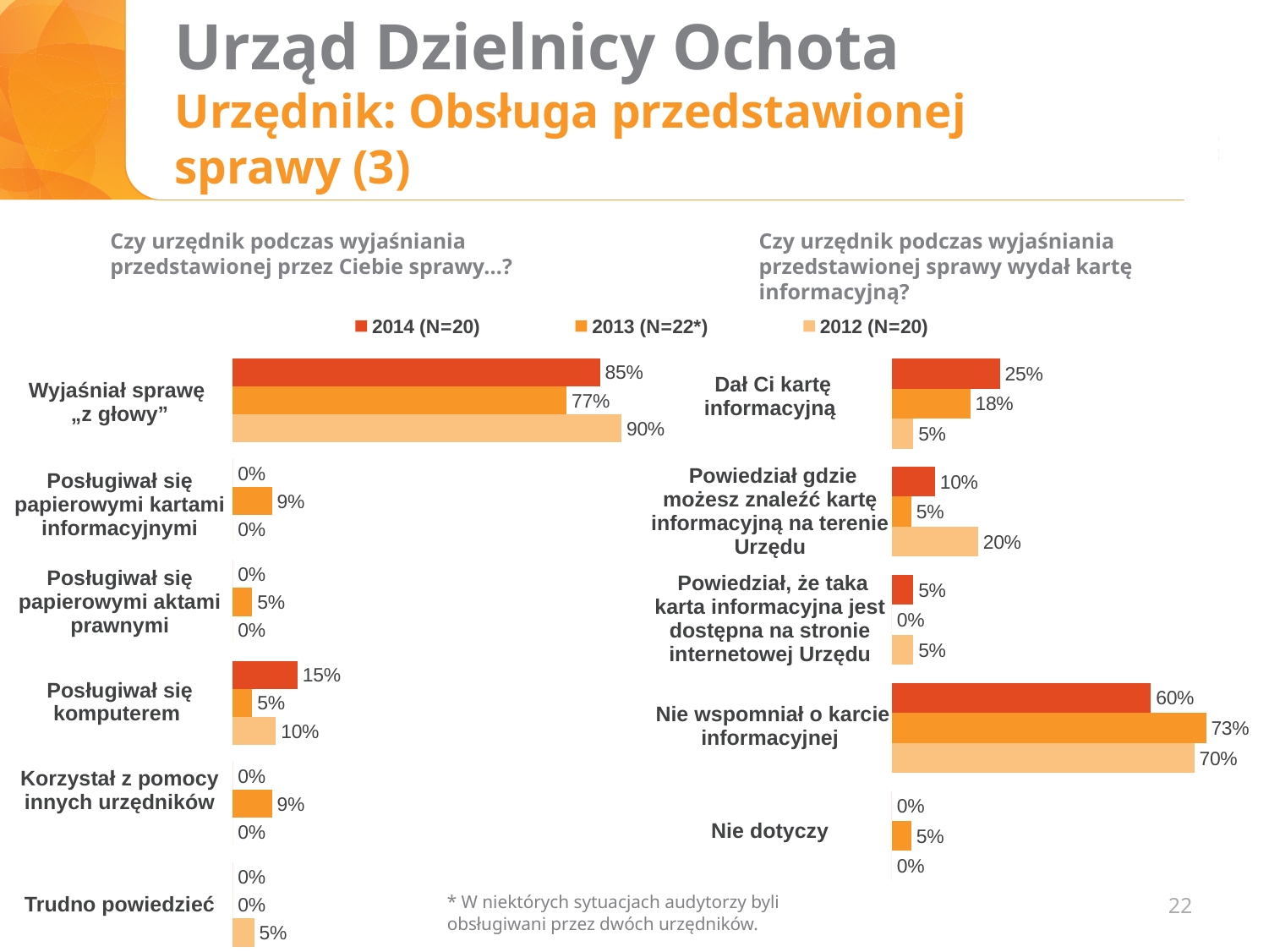
In the right chart, what is the 2012 value for "Powiedział gdzie możesz znaleźć kartę informacyjną na terenie Urzędu"? 20% In the left chart, what is the 2014 value for "Wyjaśniał sprawę „z głowy”"? 85% How many categories does the right chart show? 5 In the left chart, what is the 2013 value for "Posługiwał się papierowymi kartami informacyjnymi"? 9% In the right chart, what is the difference between the 2014 and 2012 values for "Dał Ci kartę informacyjną"? 20 percentage points How many series does the legend list? 3 In the left chart, which year has the lowest value for "Wyjaśniał sprawę „z głowy”"? 2013 In the right chart, which category has the highest 2013 value? Nie wspomniał o karcie informacyjnej In the left chart, which is larger for "Posługiwał się komputerem": the 2014 value or the 2012 value? 2014 What type of chart is used on this slide? Bar chart How many categories does the left chart show? 6 In the right chart, is the 2013 value for "Nie wspomniał o karcie informacyjnej" greater or less than the 2014 value? greater